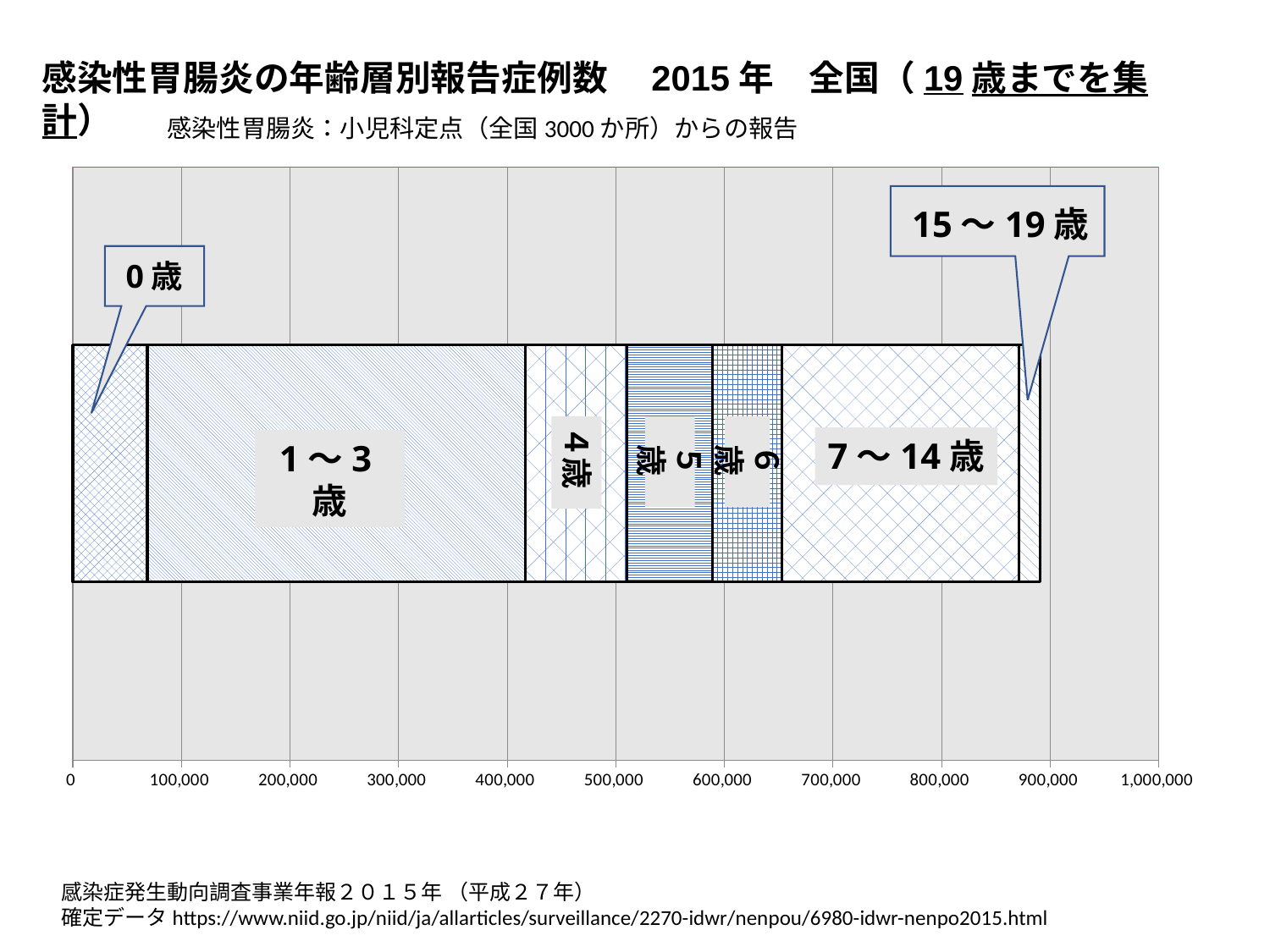
Is the value for the 1～3歳 segment greater or less than 300,000? greater How many age-group segments make up the bar? 7 What kind of chart is shown on the slide? stacked bar chart Is the value for the 0歳 segment greater or less than 100,000? less Is the value for the 7～14歳 segment greater or less than 100,000? greater Which age group has the smallest segment in the bar? 15～19歳 Which age group has the largest segment in the bar? 1～3歳 Which year does the chart title say the data is for? 2015年 What is the maximum value shown on the horizontal axis? 1,000,000 Which segment is larger, 0歳 or 15～19歳? 0歳 Which segment is larger, 1～3歳 or 7～14歳? 1～3歳